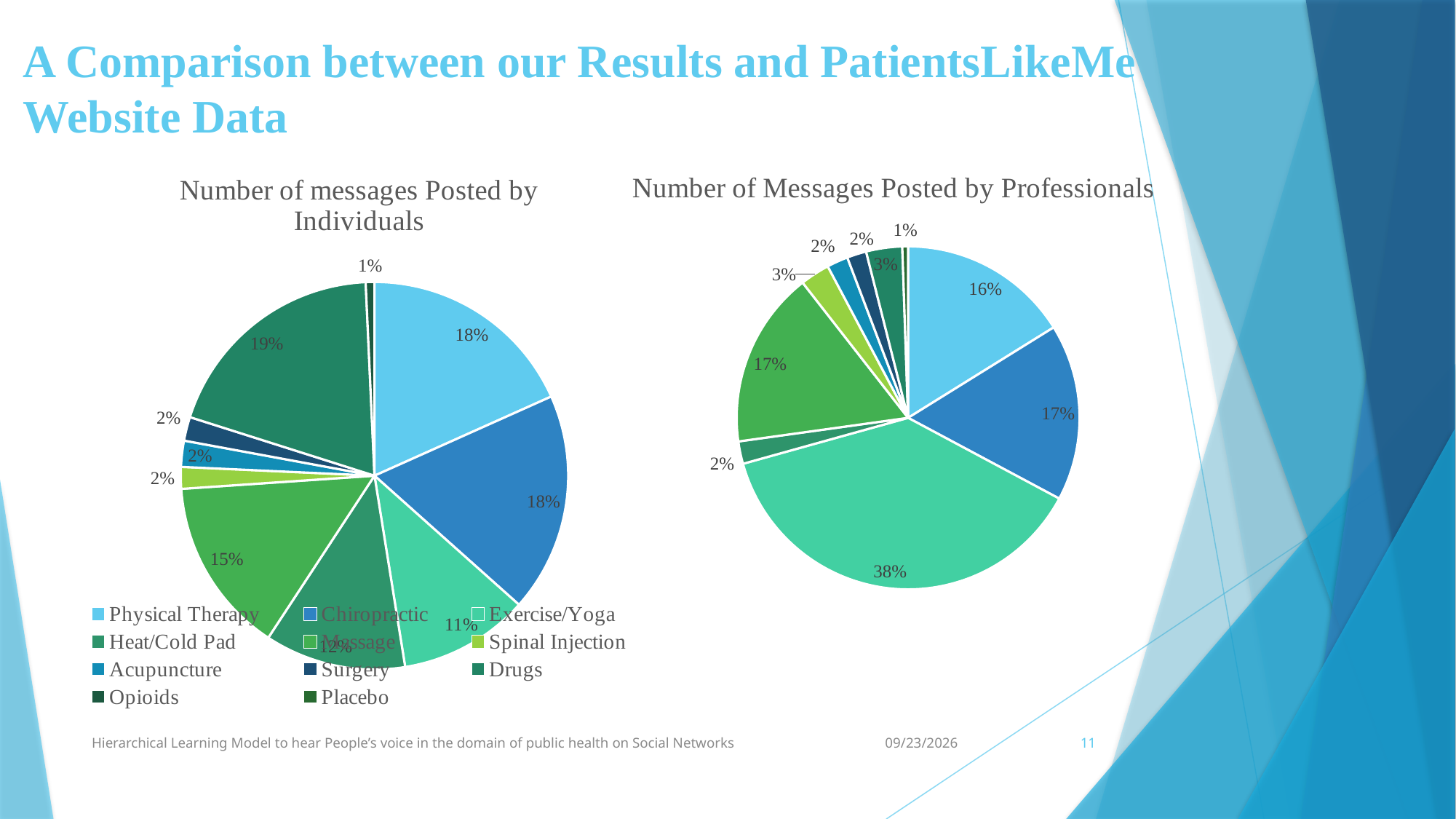
In the "Number of messages Posted by Individuals" chart, what share does Massage have? 15% How many categories does the legend list? 11 In the "Number of messages Posted by Individuals" chart, which category has the largest share? Drugs In the "Number of messages Posted by Individuals" chart, what share does Drugs have? 19% In the "Number of Messages Posted by Professionals" chart, what share does Physical Therapy have? 16% In the "Number of Messages Posted by Professionals" chart, what share does Exercise/Yoga have? 38% In the "Number of messages Posted by Individuals" chart, which category has the smallest labelled share? Opioids What type of chart is used for "Number of messages Posted by Individuals"? Pie chart In the "Number of Messages Posted by Professionals" chart, which category has the largest share? Exercise/Yoga In the "Number of Messages Posted by Professionals" chart, what is the difference between the Exercise/Yoga share and the Chiropractic share? 21% Which chart gives Exercise/Yoga a larger share, "Number of messages Posted by Individuals" or "Number of Messages Posted by Professionals"? Number of Messages Posted by Professionals What colour represents Physical Therapy in the legend? Light blue